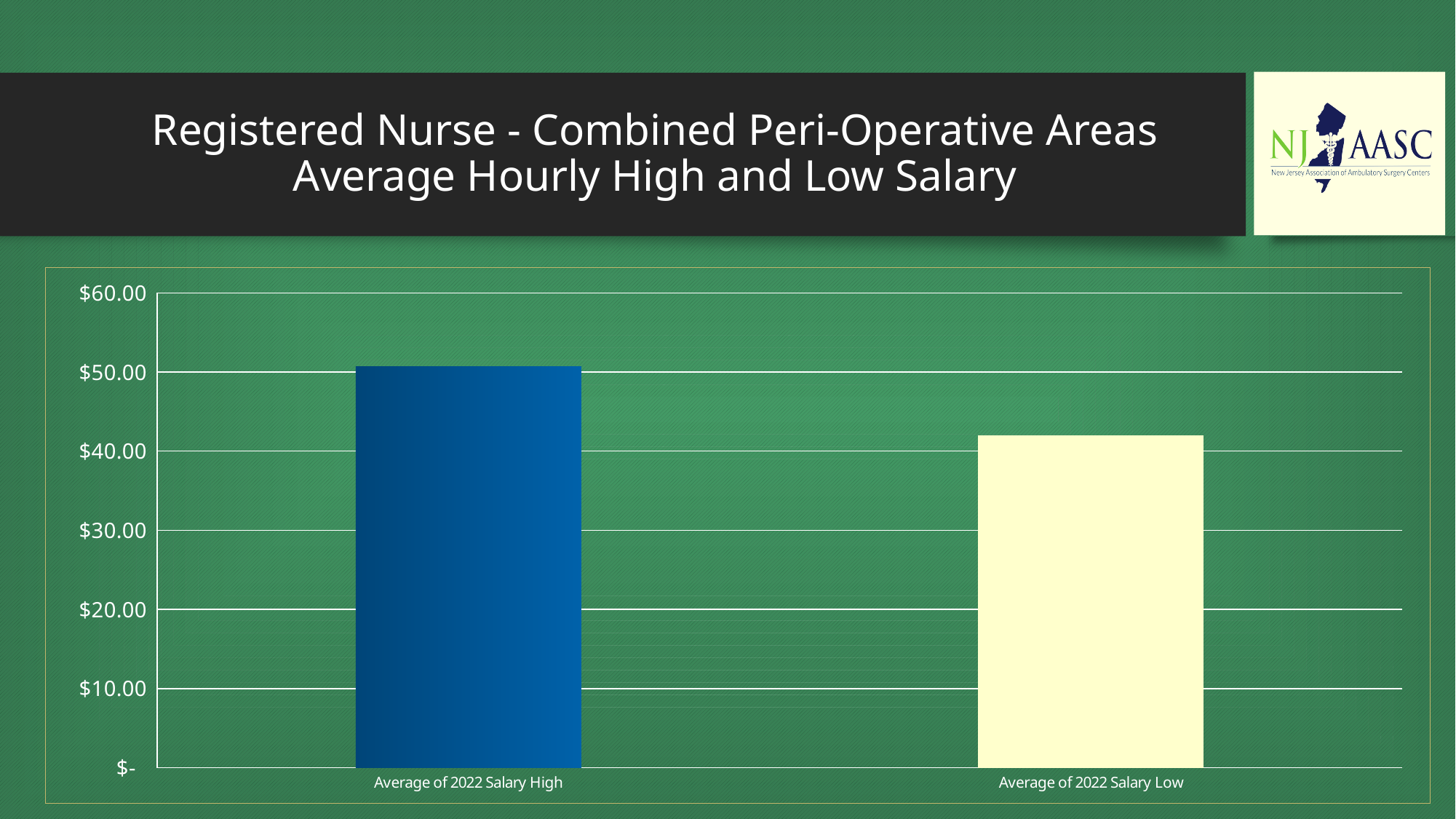
What kind of chart is shown on the slide? bar chart Is the value for Average of 2022 Salary High greater or less than $40.00? greater What colour is the bar for Average of 2022 Salary Low? pale yellow What is the highest value shown on the vertical axis? $60.00 Is the value for Average of 2022 Salary Low greater or less than $30.00? greater Is the value for Average of 2022 Salary Low greater or less than $50.00? less What is the title of the slide's chart? Registered Nurse - Combined Peri-Operative Areas Average Hourly High and Low Salary Which is larger, the value for Average of 2022 Salary High or Average of 2022 Salary Low? Average of 2022 Salary High Which category has the highest value? Average of 2022 Salary High Which category has the lowest value? Average of 2022 Salary Low How many bars are plotted in the chart? 2